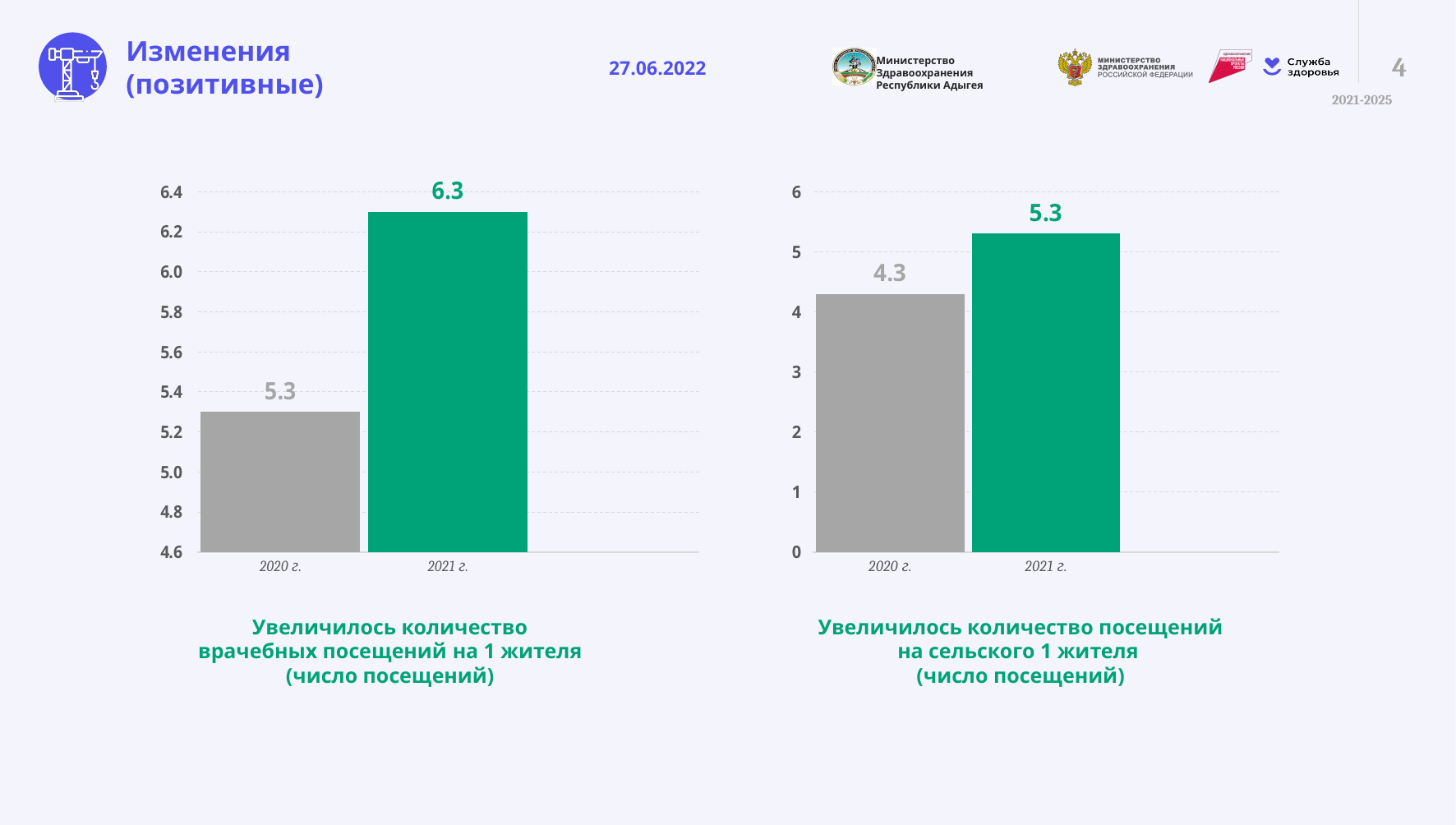
In the left chart (врачебных посещений на 1 жителя), what is the value for 2020 г.? 5.3 In the left chart, which year has the higher value? 2021 г. In the right chart, what is the difference between the 2021 г. and 2020 г. values? 1.0 How many bars are shown in the left chart? 2 In the right chart (посещений на сельского 1 жителя), what is the value for 2021 г.? 5.3 In the right chart, which year has the lower value? 2020 г. In the left chart, do the values rise or fall from 2020 г. to 2021 г.? Rise In the right chart, is the value for 2020 г. greater or less than 4? greater What type of chart is the right chart? Bar chart In the left chart (врачебных посещений на 1 жителя), what is the value for 2021 г.? 6.3 In the left chart, by how much did the value increase from 2020 г. to 2021 г.? 1.0 In the right chart (посещений на сельского 1 жителя), what is the value for 2020 г.? 4.3